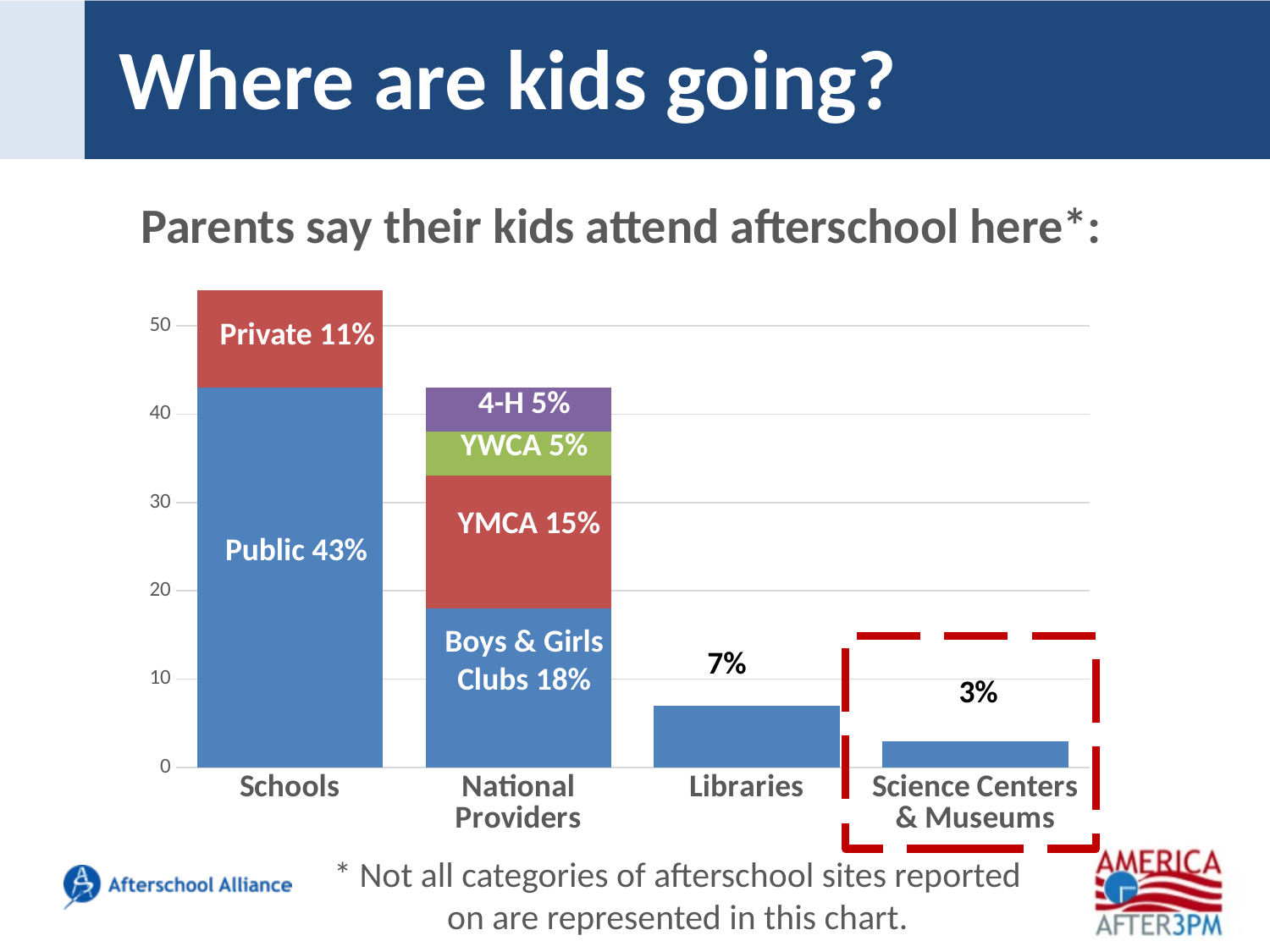
Which category is highlighted with a red dashed box on the chart? Science Centers & Museums What is the value shown for YMCA within the National Providers bar? 15% Which category has the tallest bar overall? Schools Which category has the lowest value? Science Centers & Museums What kind of chart is shown on the slide? Stacked bar chart What is the total of the National Providers stacked bar? 43% What percentage of parents say their kids attend afterschool at public schools? 43% What is the value shown for Libraries? 7% What is the difference between the Boys & Girls Clubs value and the YMCA value? 3% How many categories are shown on the x axis of the chart? 4 What is the total of the Schools stacked bar (Public plus Private)? 54% What is the value shown for Science Centers & Museums? 3%